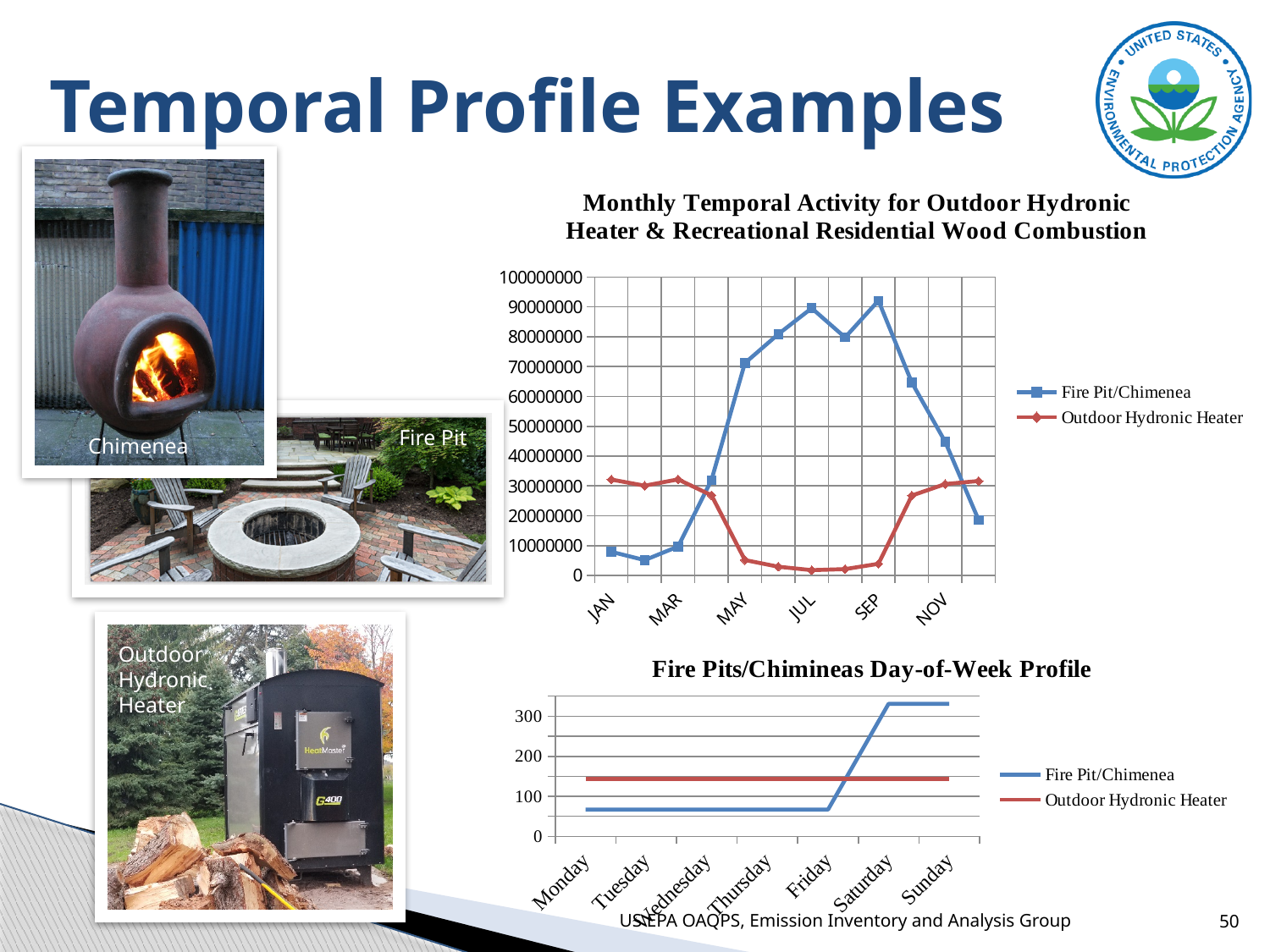
In the Fire Pits/Chimineas Day-of-Week Profile chart, how many days are shown on the x axis? 7 In the Monthly Temporal Activity chart, which series has the higher value in JAN, Fire Pit/Chimenea or Outdoor Hydronic Heater? Outdoor Hydronic Heater In the Fire Pits/Chimineas Day-of-Week Profile chart, which series has the higher value on Sunday, Fire Pit/Chimenea or Outdoor Hydronic Heater? Fire Pit/Chimenea In the Monthly Temporal Activity chart, is the Fire Pit/Chimenea value for JUL greater or less than 80000000? greater In the Fire Pits/Chimineas Day-of-Week Profile chart, is the Fire Pit/Chimenea value for Monday greater or less than 100? less In the Monthly Temporal Activity chart, does the Fire Pit/Chimenea series rise or fall from SEP to the end of the year? fall In the Monthly Temporal Activity chart, is the Outdoor Hydronic Heater value for JAN greater or less than 20000000? greater In the Monthly Temporal Activity chart, which series has the higher value in JUL, Fire Pit/Chimenea or Outdoor Hydronic Heater? Fire Pit/Chimenea In the Monthly Temporal Activity chart, how many series does the legend list? 2 What kind of chart is the Monthly Temporal Activity for Outdoor Hydronic Heater & Recreational Residential Wood Combustion chart? line chart